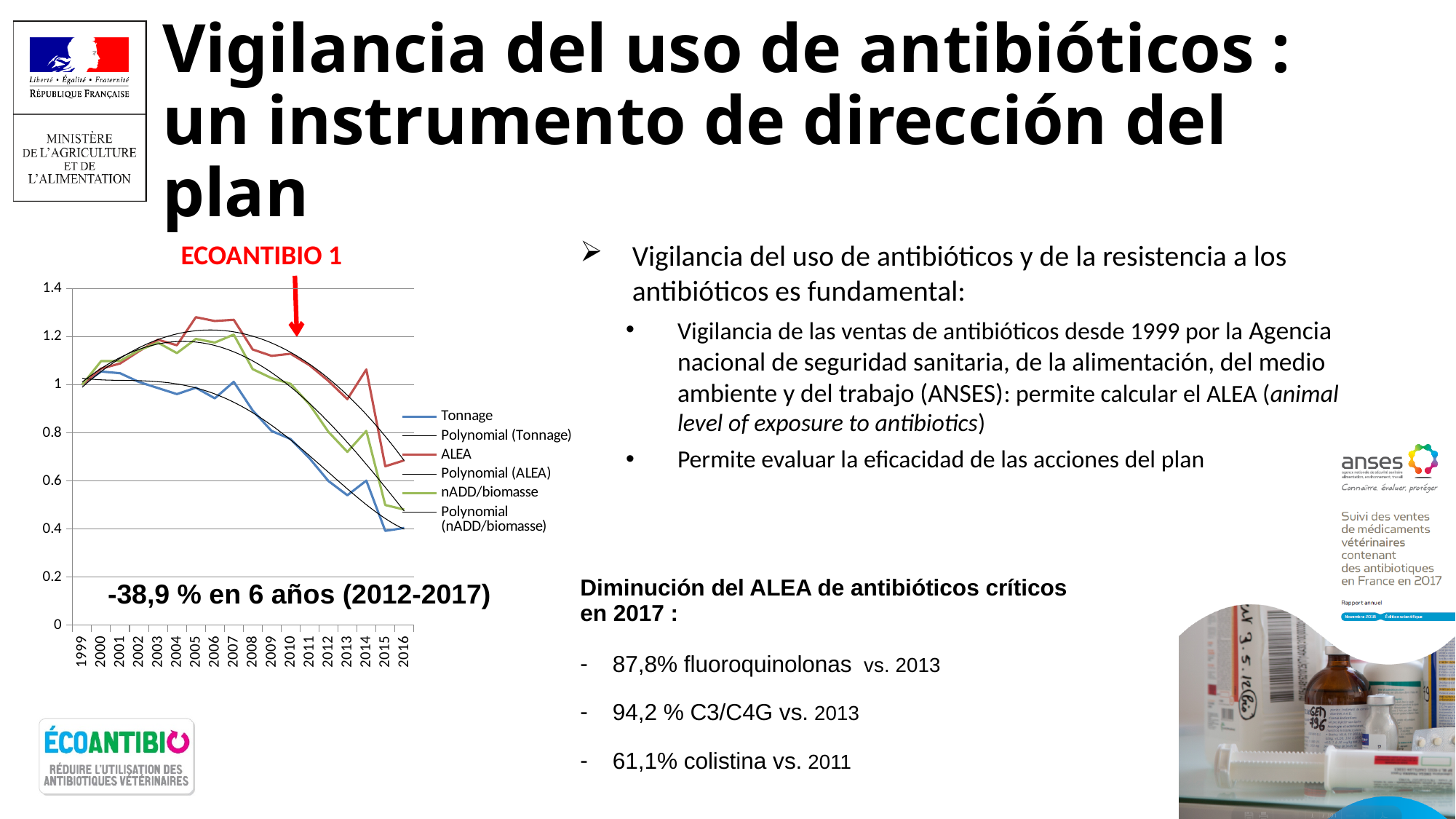
What is the first year shown on the x axis of the chart? 1999 Is the value for ALEA in 2005 greater or less than 1.2? greater Do the plotted series rise or fall between 2007 and 2016? fall How many entries does the chart legend list? 6 Which series has the highest value in 2016? ALEA What kind of chart is shown on the slide? line chart Is the value for Tonnage in 2016 greater or less than 0.6? less Which series has the lowest value in 2016? Tonnage Is the value for Tonnage in 2010 greater or less than 1? less In 2013, which is larger: the ALEA value or the Tonnage value? ALEA How many years are shown along the x axis of the chart? 18